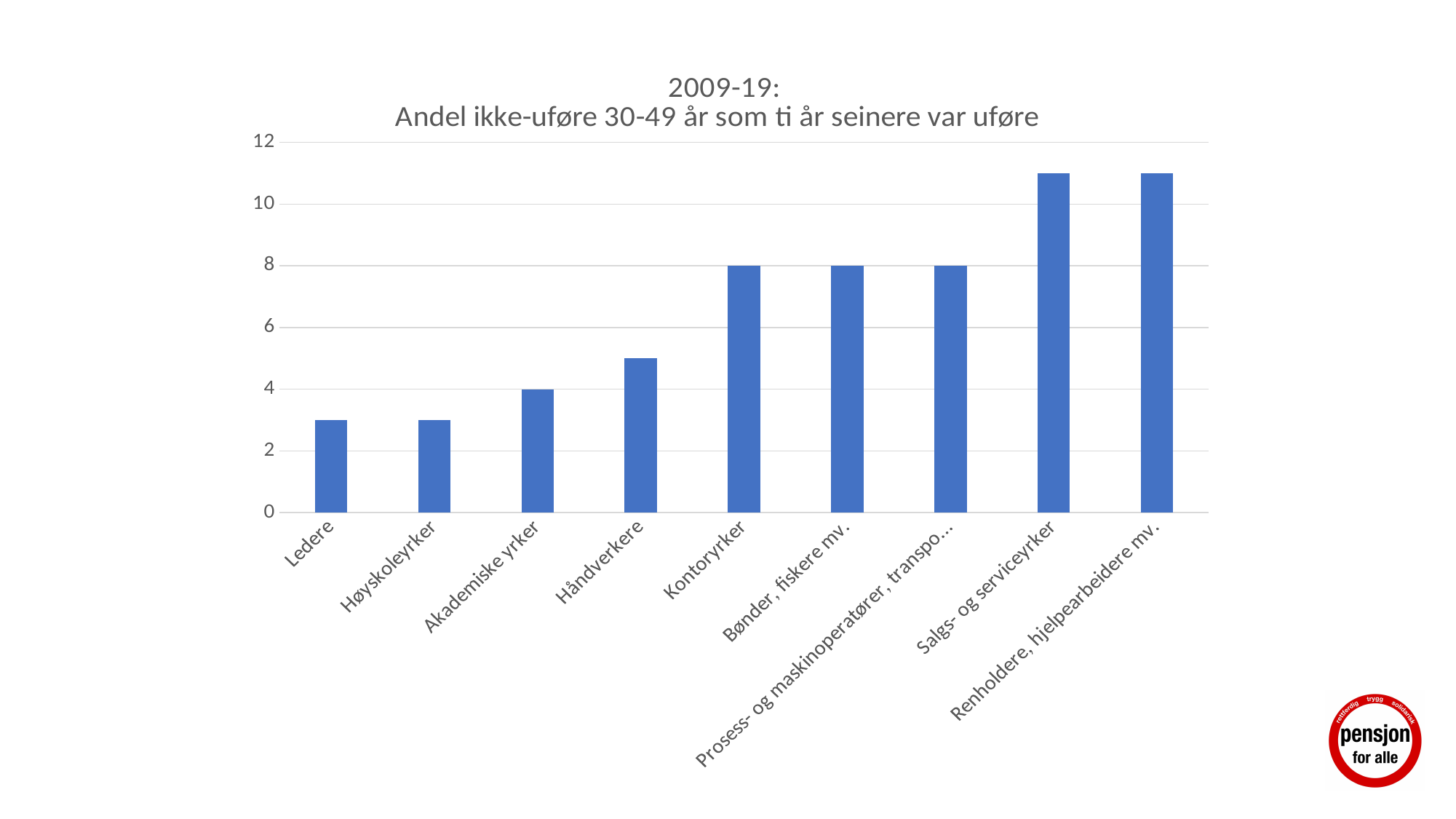
What is the value for Bønder, fiskere mv.? 8 What is the value for Akademiske yrker? 4 Is the value for Ledere greater or less than 4? less How many occupational categories are shown on the x axis? 9 Is the value for Håndverkere greater or less than 6? less What is the value for Kontoryrker? 8 What period is named in the chart title? 2009-19 What kind of chart is shown on the slide? bar chart Is the value for Salgs- og serviceyrker greater or less than 10? greater Which is larger, the value for Håndverkere or the value for Kontoryrker? Kontoryrker Do the values generally rise or fall from left to right along the x axis? rise What is the difference between the value for Kontoryrker and the value for Akademiske yrker? 4